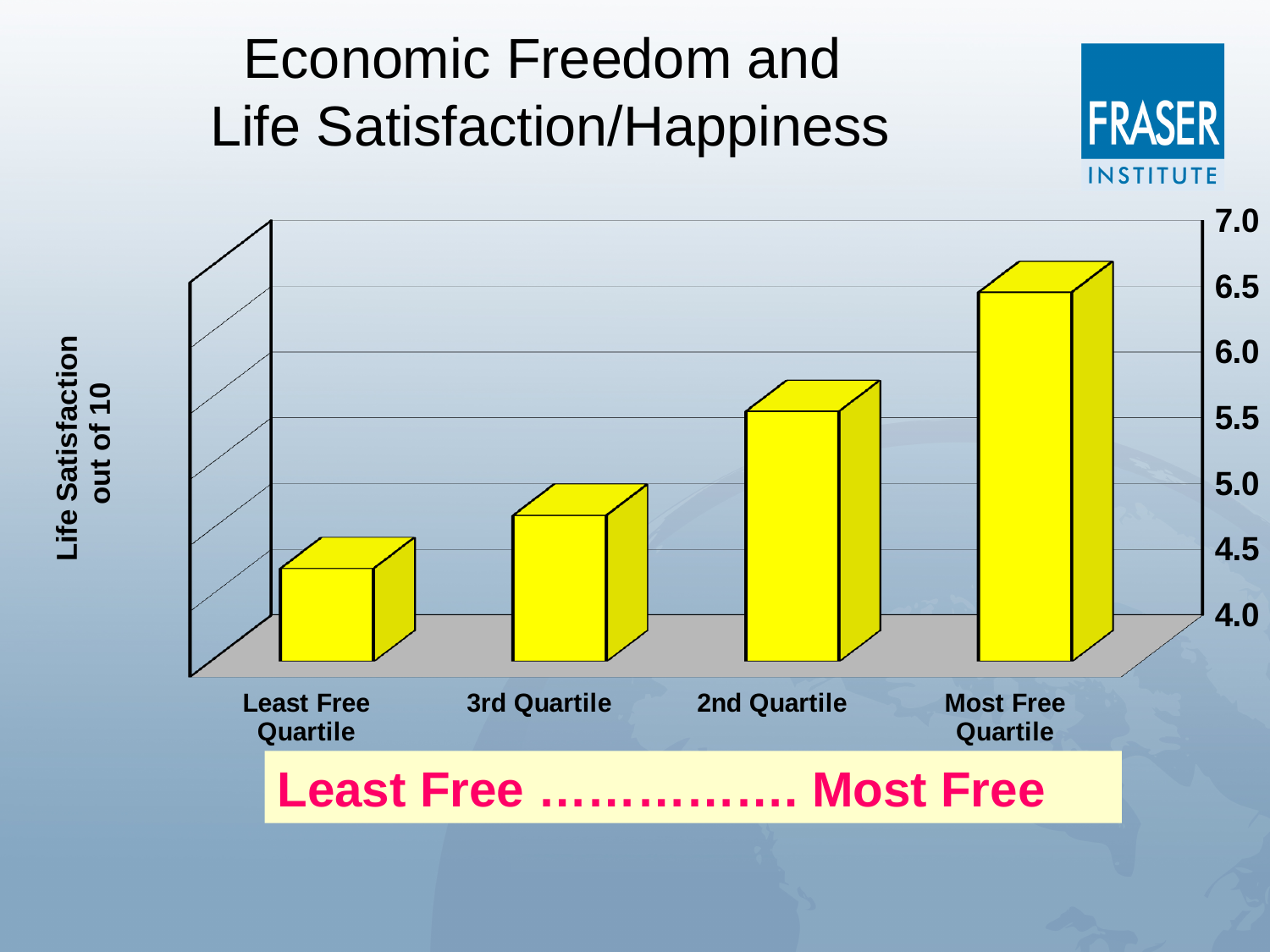
What is the label on the vertical axis of the chart? Life Satisfaction out of 10 Which has a higher value, the 2nd Quartile or the 3rd Quartile? 2nd Quartile How many categories (bars) are plotted in the chart? 4 Is the value for the Least Free Quartile greater or less than 5.0? less Is the value for the 3rd Quartile greater or less than 5.5? less Which category has the lowest life satisfaction value? Least Free Quartile What kind of chart is shown on the slide? bar chart What is the highest value shown on the vertical axis scale? 7.0 Do the values rise or fall moving from the Least Free Quartile to the Most Free Quartile? rise Is the value for the 2nd Quartile greater or less than 5.5? greater Which category has the highest life satisfaction value? Most Free Quartile